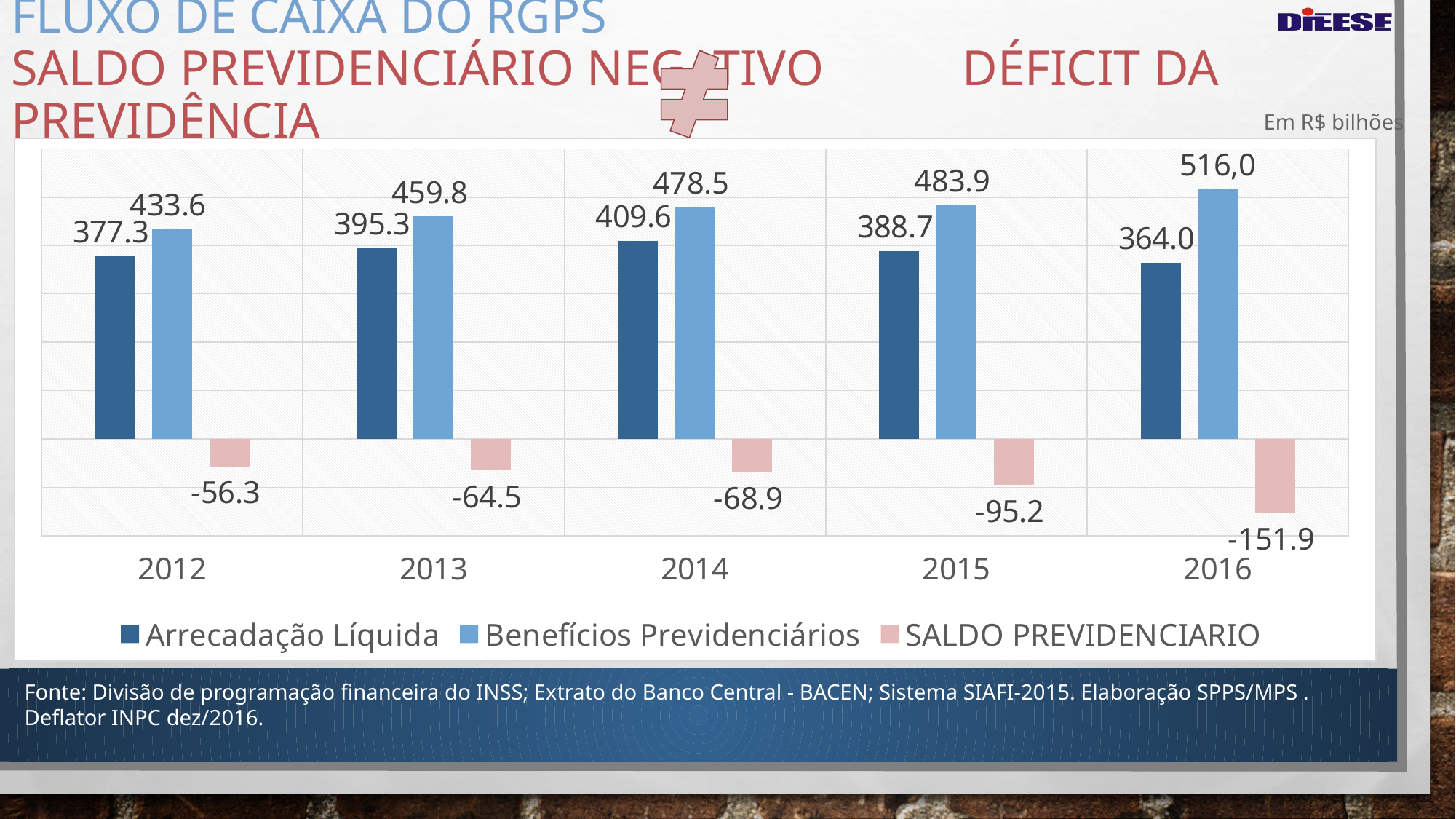
What is the difference between Benefícios Previdenciários and Arrecadação Líquida in 2012? 56.3 How many series does the legend list? 3 Do the Benefícios Previdenciários values rise or fall from 2012 to 2016? Rise What is the SALDO PREVIDENCIARIO value for 2015? -95.2 What kind of chart is shown on the slide? Bar chart Which is larger in 2013: Arrecadação Líquida or Benefícios Previdenciários? Benefícios Previdenciários What is the value of Arrecadação Líquida in 2014? 409.6 What unit is indicated for the chart values? Em R$ bilhões In which year is the SALDO PREVIDENCIARIO lowest (most negative)? 2016 What is the value of Benefícios Previdenciários in 2016? 516,0 In which year is Arrecadação Líquida highest? 2014 How many years are shown on the x axis? 5